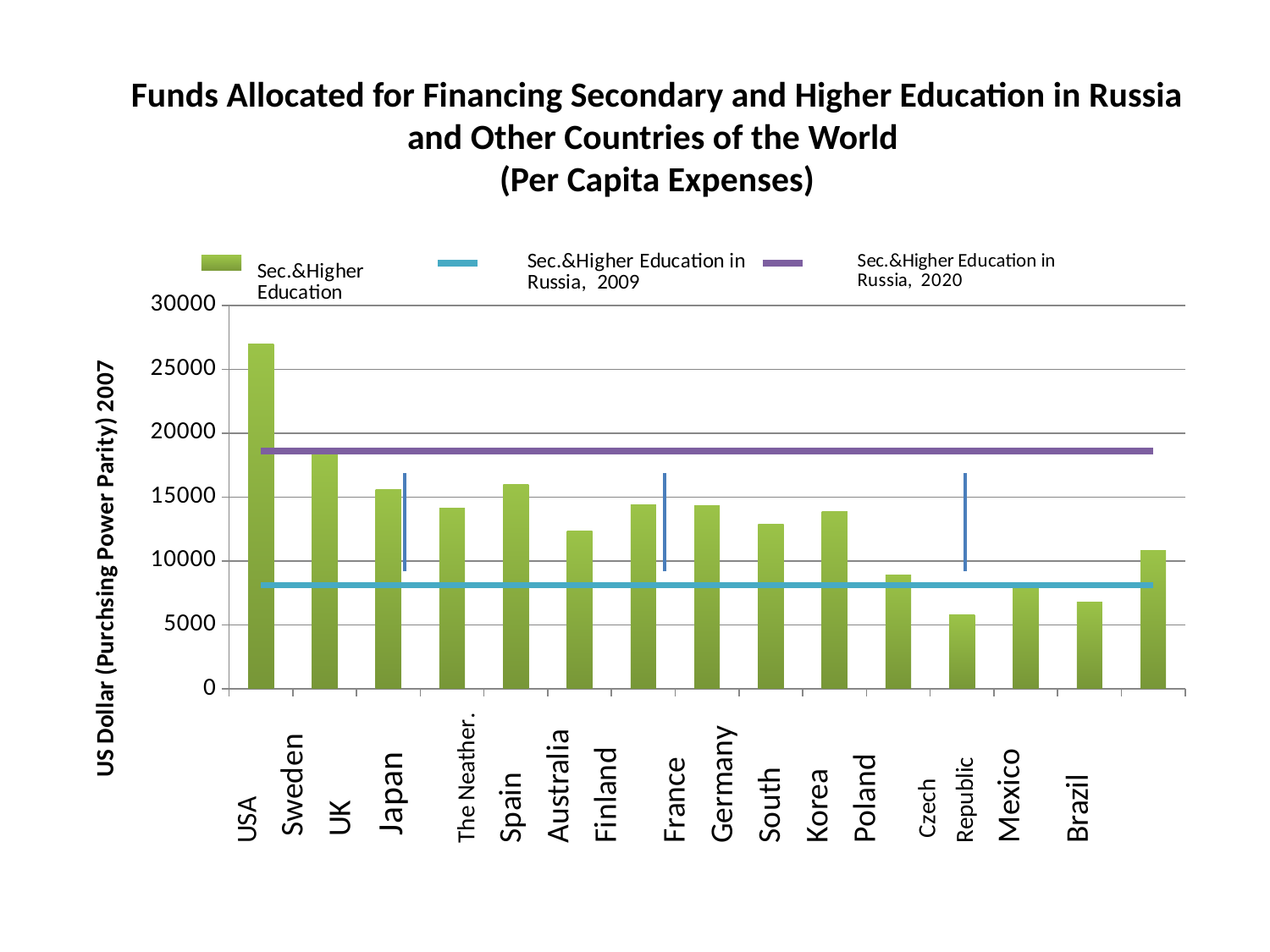
Which is larger, the value for USA or the value for Sweden? USA Is the Sec.&Higher Education in Russia, 2020 line greater or less than 15000? greater What is the title of the vertical axis? US Dollar (Purchsing Power Parity) 2007 What is the maximum value shown on the vertical axis? 30000 Is the Sec.&Higher Education in Russia, 2009 line greater or less than 10000? less How many series does the legend list? 3 How many bars are plotted in the chart? 15 Which country has the highest value for Sec.&Higher Education? USA Is the value for USA greater or less than 25000? greater What kind of chart is shown on the slide? combination bar and line chart